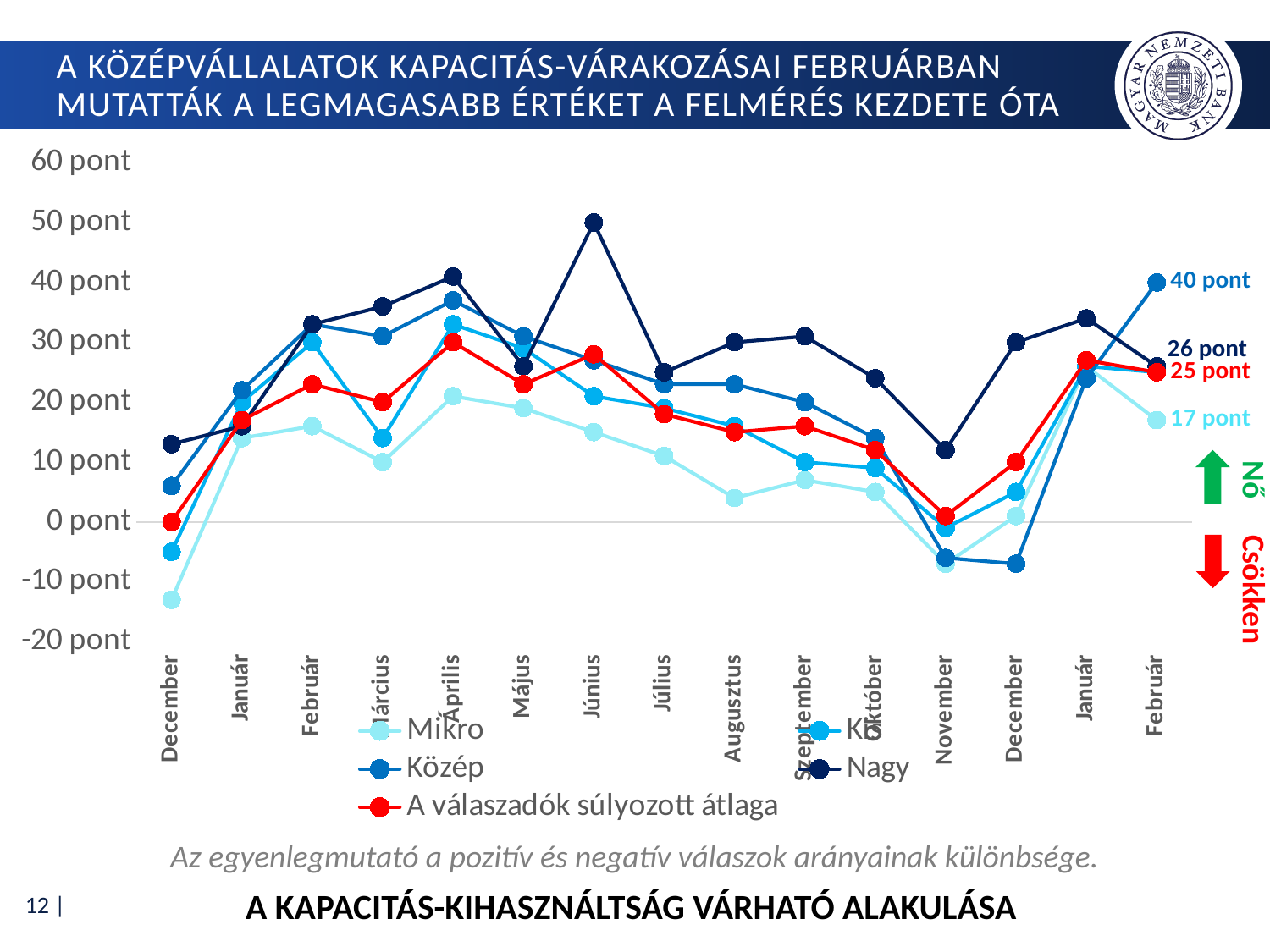
How many series does the legend list? 5 Which series has the highest value at the final Február point? Közép What is the value of 'A válaszadók súlyozott átlaga' at the final Február point? 25 pont What kind of chart is shown on the slide? line chart What is the value of the Nagy series at the final Február point? 26 pont Is the value of the Mikro series at the first December point greater or less than -10 pont? less Is the value of the Nagy series in Június greater or less than 40 pont? greater At the final Február point, which is larger: the Közép value or the Nagy value? Közép What is the difference between the Közép and Mikro values at the final Február point? 23 pont What is the value of the Mikro series at the final Február point? 17 pont What is the value of the Közép series at the final Február point? 40 pont How many months are shown on the x axis? 15